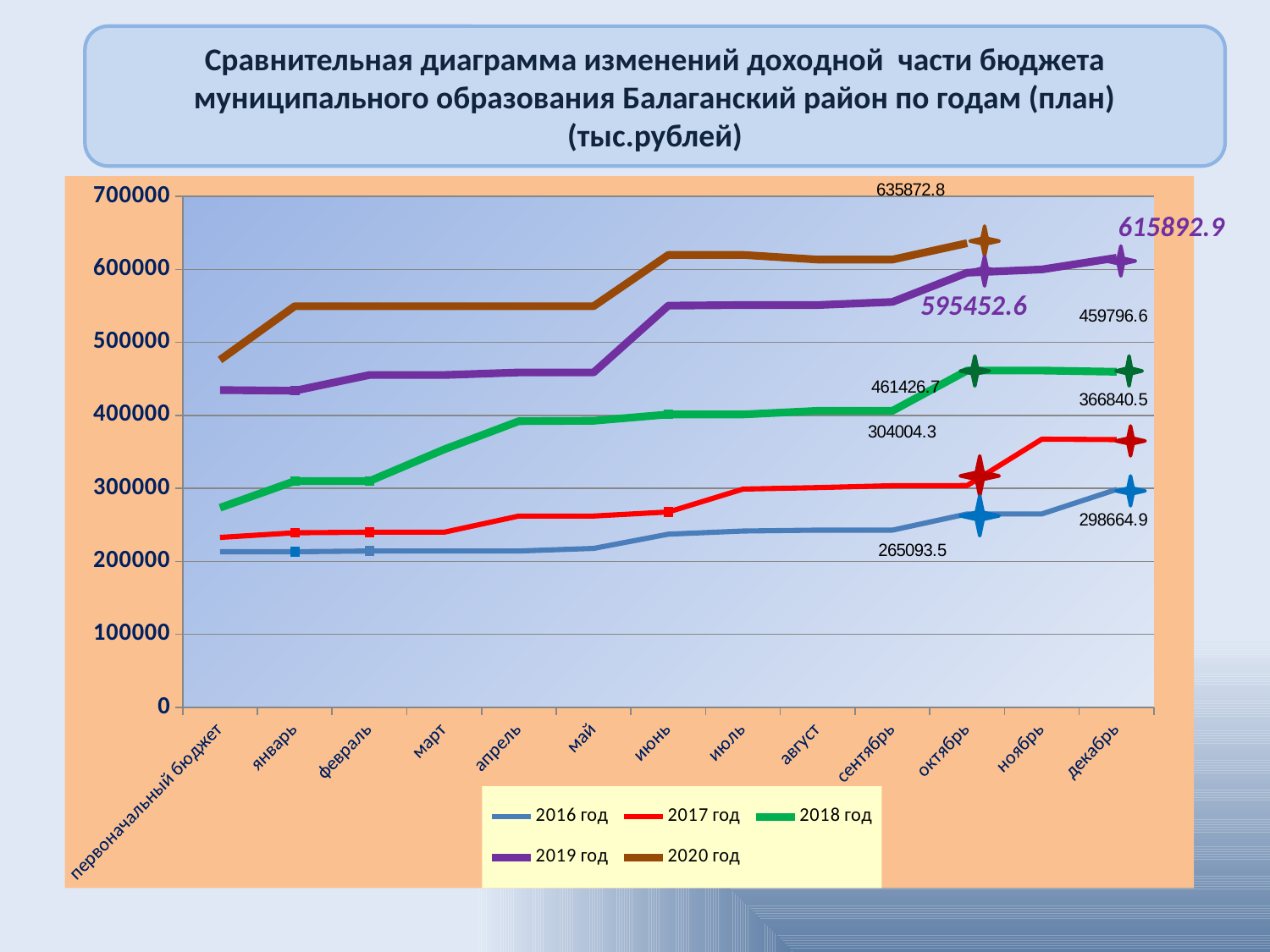
Which series has the highest value in октябрь? 2020 год Does the 2016 год series generally rise or fall from первоначальный бюджет to декабрь? rise What is the value for 2016 год in декабрь? 298664.9 What is the difference between the 2019 год values in декабрь and октябрь? 20440.3 Is the value for 2019 год at первоначальный бюджет greater or less than 400000? greater What is the value for 2019 год in декабрь? 615892.9 What is the value for 2020 год in октябрь? 635872.8 What kind of chart is shown on the slide? line chart How many series does the legend list? 5 How many categories are on the x axis? 13 What is the value for 2017 год in октябрь? 304004.3 What is the difference between the 2017 год values in декабрь and октябрь? 62836.2